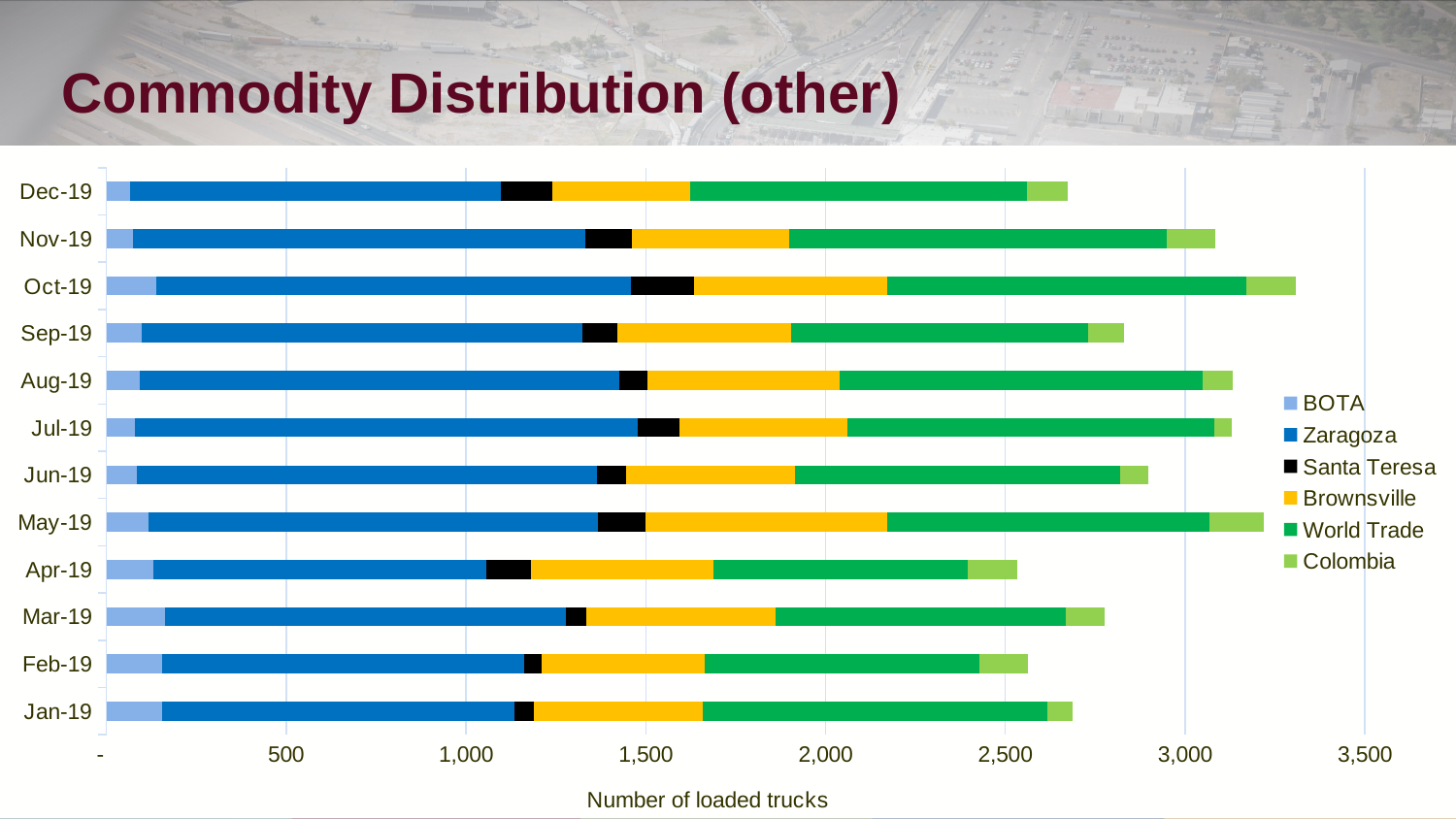
Is the total bar for Oct-19 greater or less than 3,000? greater Is the total bar for Dec-19 greater or less than 3,000? less Which month has the larger total bar, Oct-19 or Apr-19? Oct-19 What is the label on the horizontal axis of the chart? Number of loaded trucks How many series does the legend list? 6 Which series is listed first in the legend? BOTA Which month has the longest total bar (highest total number of loaded trucks)? Oct-19 Is the total bar for Apr-19 greater or less than 3,000? less Which month has the larger total bar, Jul-19 or Feb-19? Jul-19 Which month has the shortest total bar (lowest total number of loaded trucks)? Apr-19 What kind of chart is shown on the slide? Stacked bar chart How many months (categories) are plotted on the chart? 12